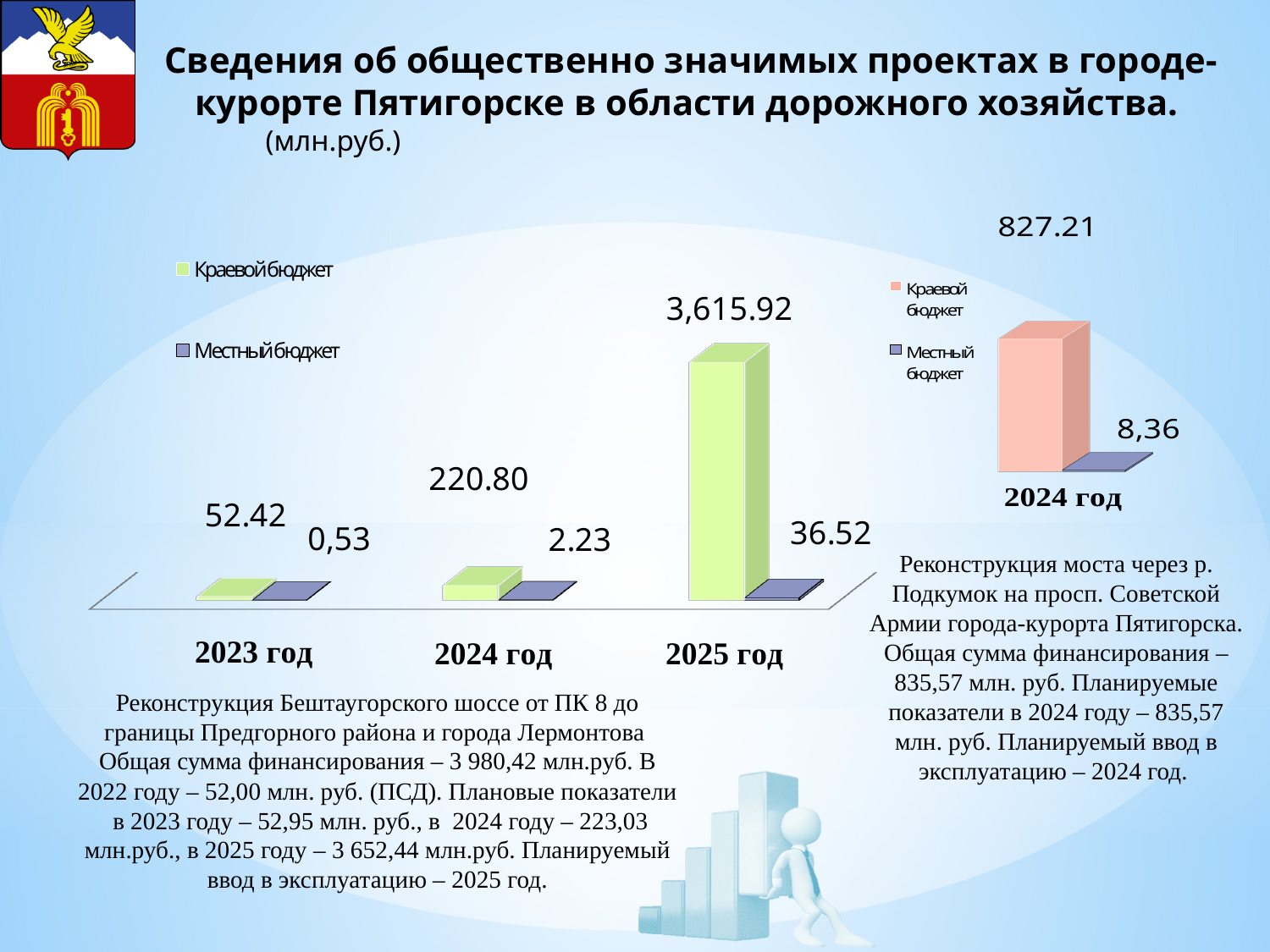
In the left chart, what is the value for Местный бюджет in 2024 год? 2.23 In the left chart, what is the value for Краевой бюджет in 2023 год? 52.42 In the left chart, what is the value for Краевой бюджет in 2025 год? 3,615.92 In the left chart, which is larger: Краевой бюджет in 2024 год or Местный бюджет in 2025 год? Краевой бюджет in 2024 год In the right chart, what is the value for Местный бюджет in 2024 год? 8,36 What kind of chart is the left chart? Bar chart How many series does the legend of the right chart list? 2 In the right chart, what is the value for Краевой бюджет in 2024 год? 827.21 In the left chart, which year has the highest value for Краевой бюджет? 2025 год How many years are shown on the x axis of the left chart? 3 In the left chart, which year has the lowest value for Местный бюджет? 2023 год In the left chart, what is the difference between the Краевой бюджет values for 2024 год and 2023 год? 168.38